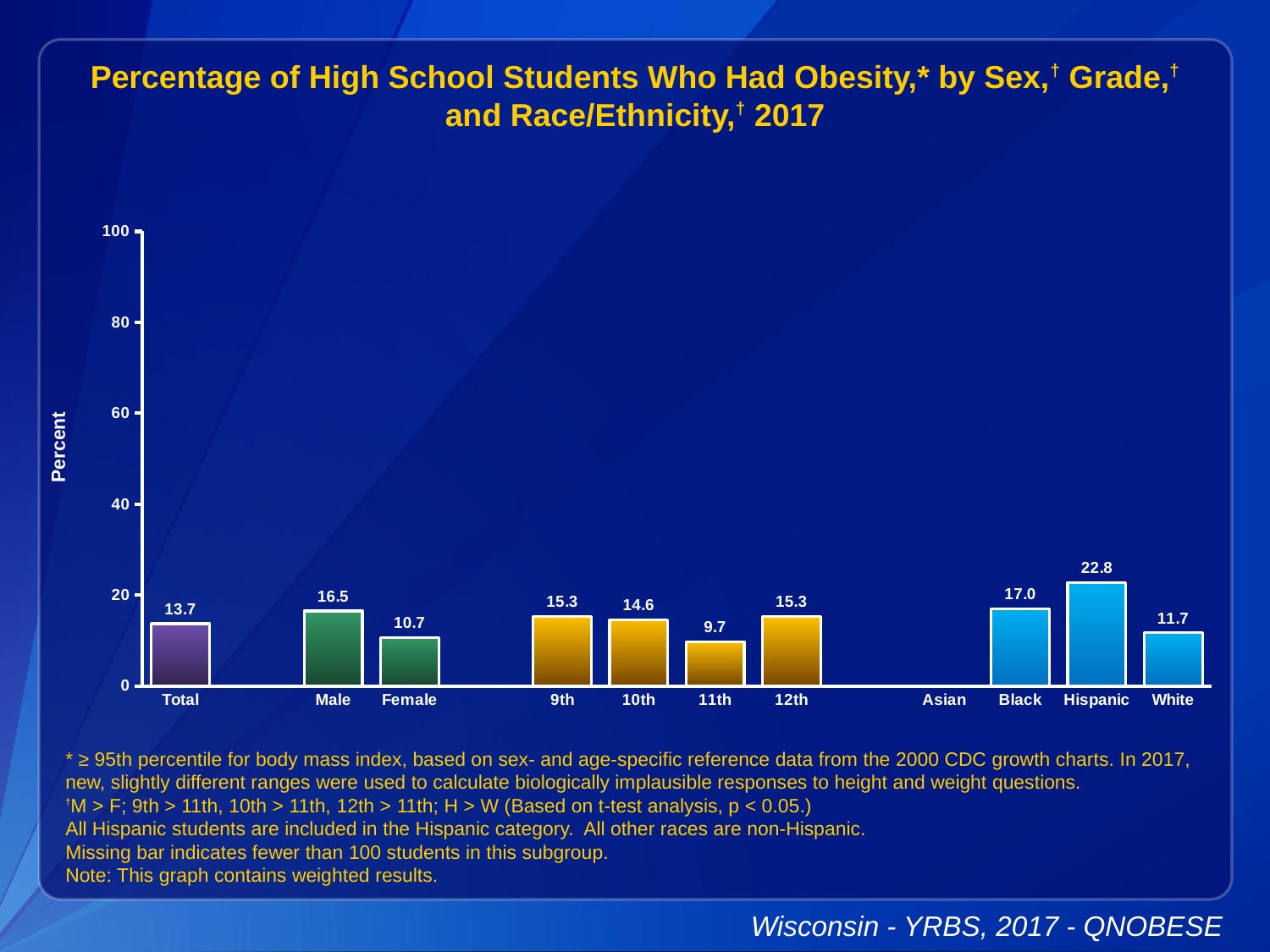
Is the value for Hispanic students greater or less than 20? greater What is the value for 11th grade students? 9.7 Which is larger, the value for Black students or the value for White students? Black How many categories have a bar plotted on the chart? 10 Which category has the highest value on the chart? Hispanic Which category with a plotted bar has the lowest value? 11th What is the percentage of high school students who had obesity in the Total category? 13.7 What kind of chart is shown on the slide? bar chart Which category on the x axis has no bar plotted? Asian What is the difference between the Male and Female values? 5.8 What is the label of the y axis? Percent What is the value for Hispanic students? 22.8